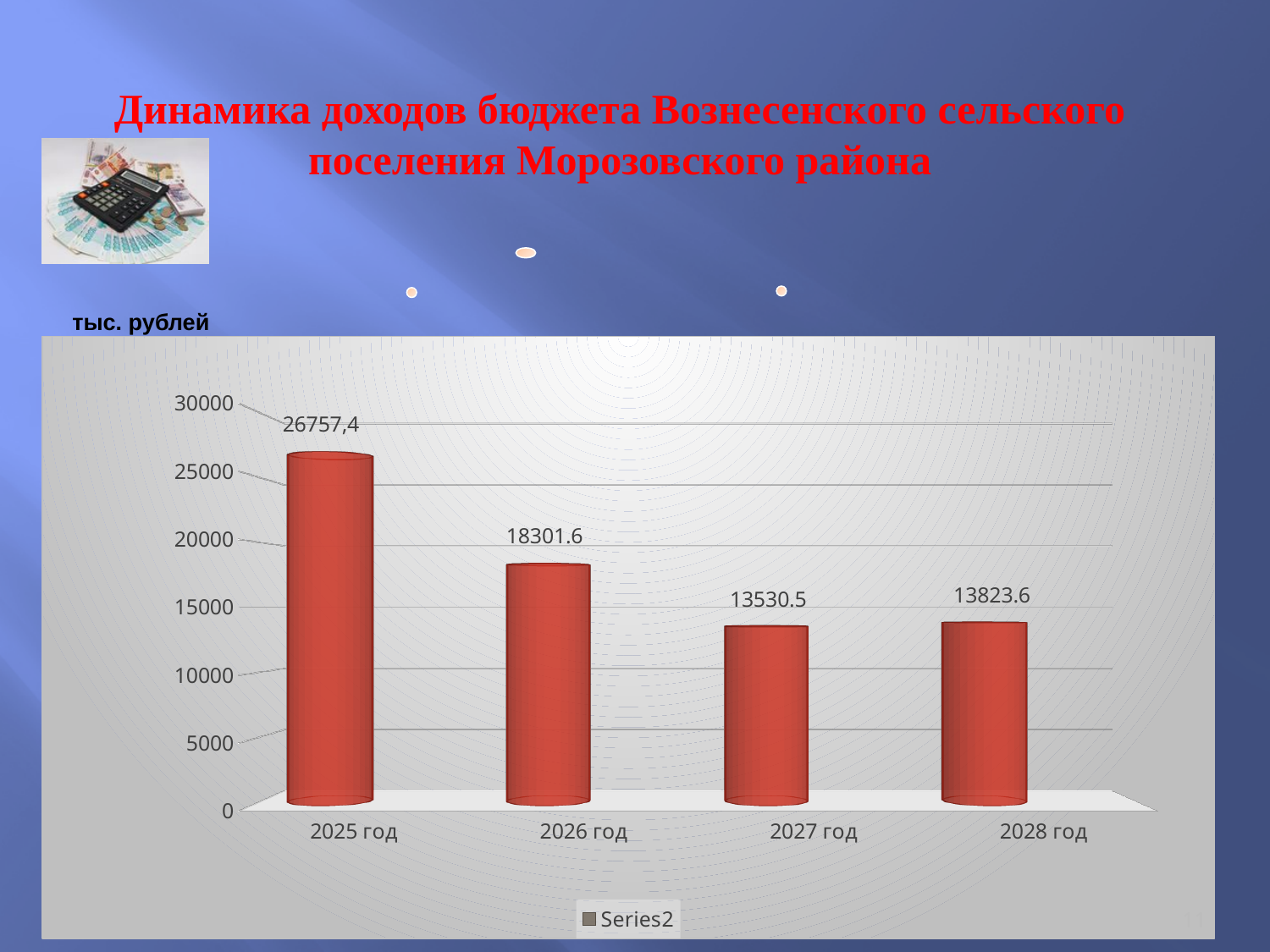
What is the value for 2025 год? 26757,4 What kind of chart is shown on the slide? bar chart Which year has the highest value? 2025 год What is the value for 2028 год? 13823.6 Which is larger, the value for 2027 год or 2028 год? 2028 год What series name does the legend show? Series2 What is the difference between the values for 2026 год and 2027 год? 4771.1 How many years are shown on the x axis? 4 What is the value for 2026 год? 18301.6 Which year has the lowest value? 2027 год Is the value for 2026 год greater or less than 20000? less What is the value for 2027 год? 13530.5